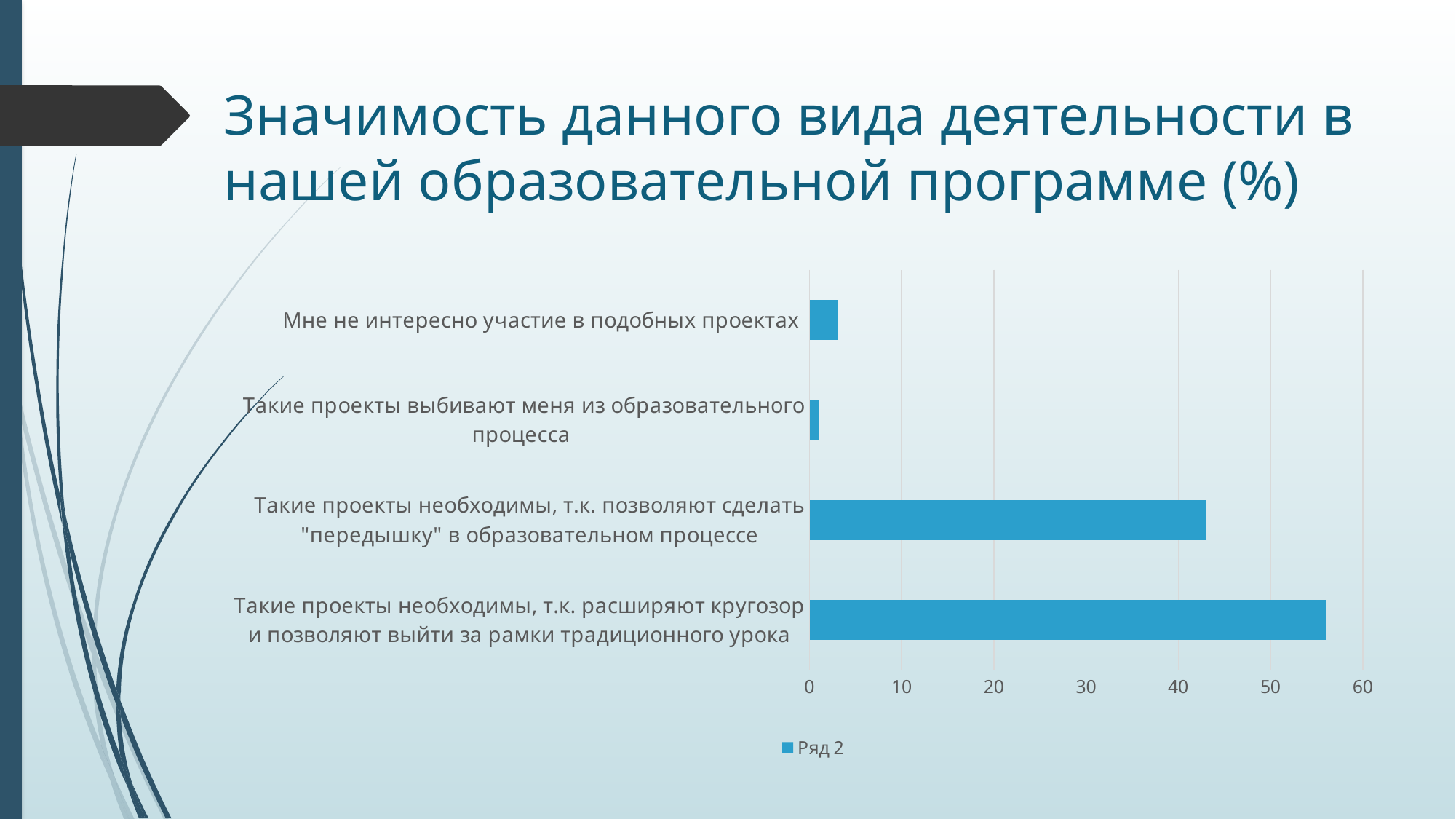
Is the value for "Такие проекты необходимы, т.к. позволяют сделать "передышку" в образовательном процессе" greater or less than 40? greater What kind of chart is shown on the slide? bar chart Which category has the highest value? Такие проекты необходимы, т.к. расширяют кругозор и позволяют выйти за рамки традиционного урока Is the value for "Такие проекты необходимы, т.к. расширяют кругозор и позволяют выйти за рамки традиционного урока" greater or less than 50? greater What is the title of the slide containing the chart? Значимость данного вида деятельности в нашей образовательной программе (%) Which is larger: the value for "Мне не интересно участие в подобных проектах" or the value for "Такие проекты выбивают меня из образовательного процесса"? Мне не интересно участие в подобных проектах Is the value for "Мне не интересно участие в подобных проектах" greater or less than 10? less Which category has the lowest value? Такие проекты выбивают меня из образовательного процесса How many series does the legend list? 1 What is the name of the series shown in the legend? Ряд 2 How many categories are plotted in the chart? 4